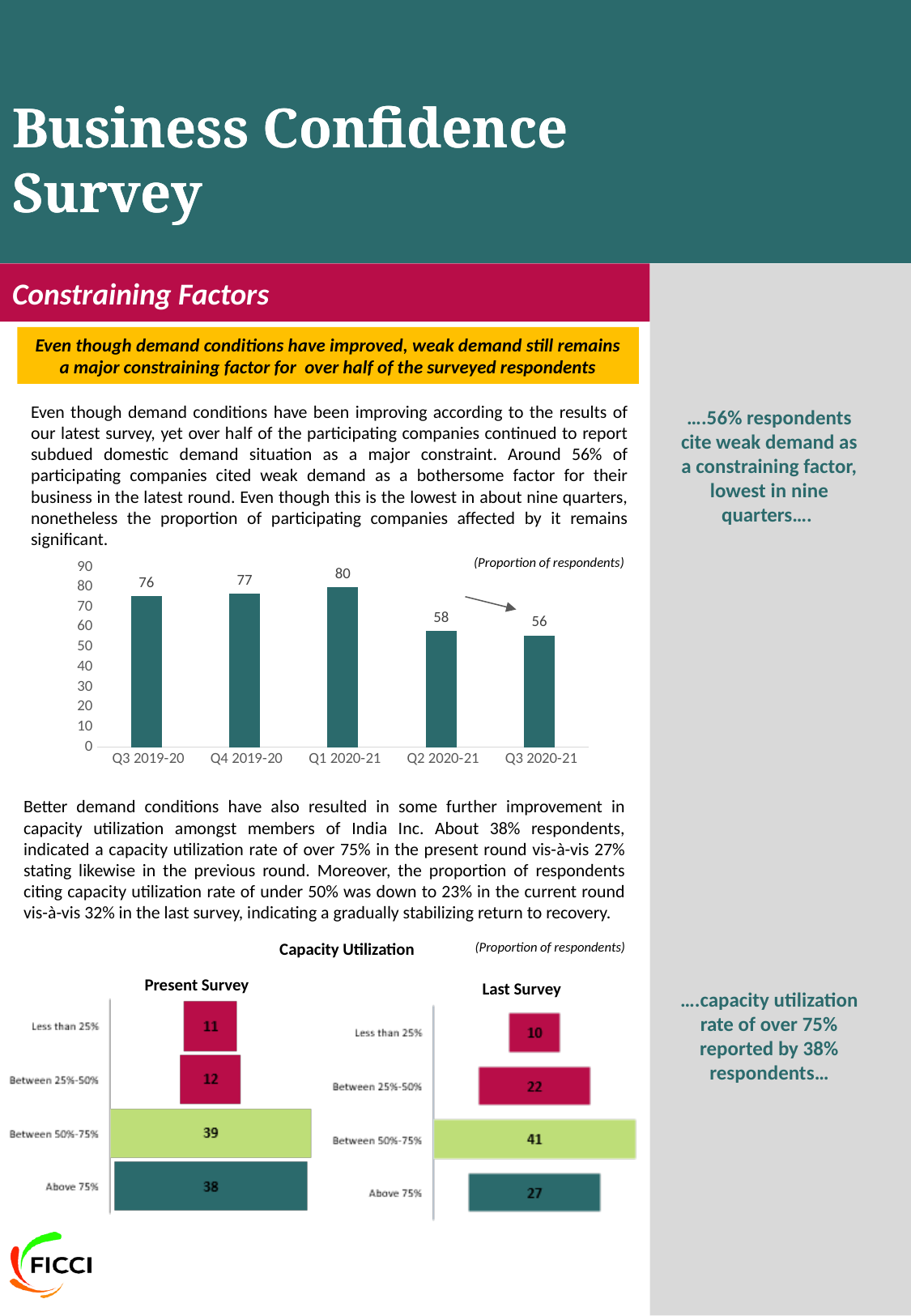
In the Capacity Utilization Present Survey chart, what is the value for Between 50%-75%? 39 In the top bar chart showing the proportion of respondents citing weak demand, what is the value for Q3 2020-21? 56 In the top bar chart showing the proportion of respondents citing weak demand, what is the value for Q1 2020-21? 80 In the Capacity Utilization charts, which is larger: the Above 75% value in the Present Survey or in the Last Survey? Present Survey In the top bar chart showing the proportion of respondents citing weak demand, which quarter has the highest value? Q1 2020-21 In the top bar chart showing the proportion of respondents citing weak demand, do the values rise or fall from Q1 2020-21 to Q3 2020-21? Fall In the top bar chart showing the proportion of respondents citing weak demand, which quarter has the lowest value? Q3 2020-21 In the top bar chart showing the proportion of respondents citing weak demand, how many quarters are plotted? 5 In the top bar chart showing the proportion of respondents citing weak demand, what is the difference between the values for Q1 2020-21 and Q2 2020-21? 22 In the Capacity Utilization Last Survey chart, which category has the highest value? Between 50%-75% In the Capacity Utilization Last Survey chart, what is the value for Above 75%? 27 What kind of chart is the top chart showing the proportion of respondents citing weak demand? Bar chart